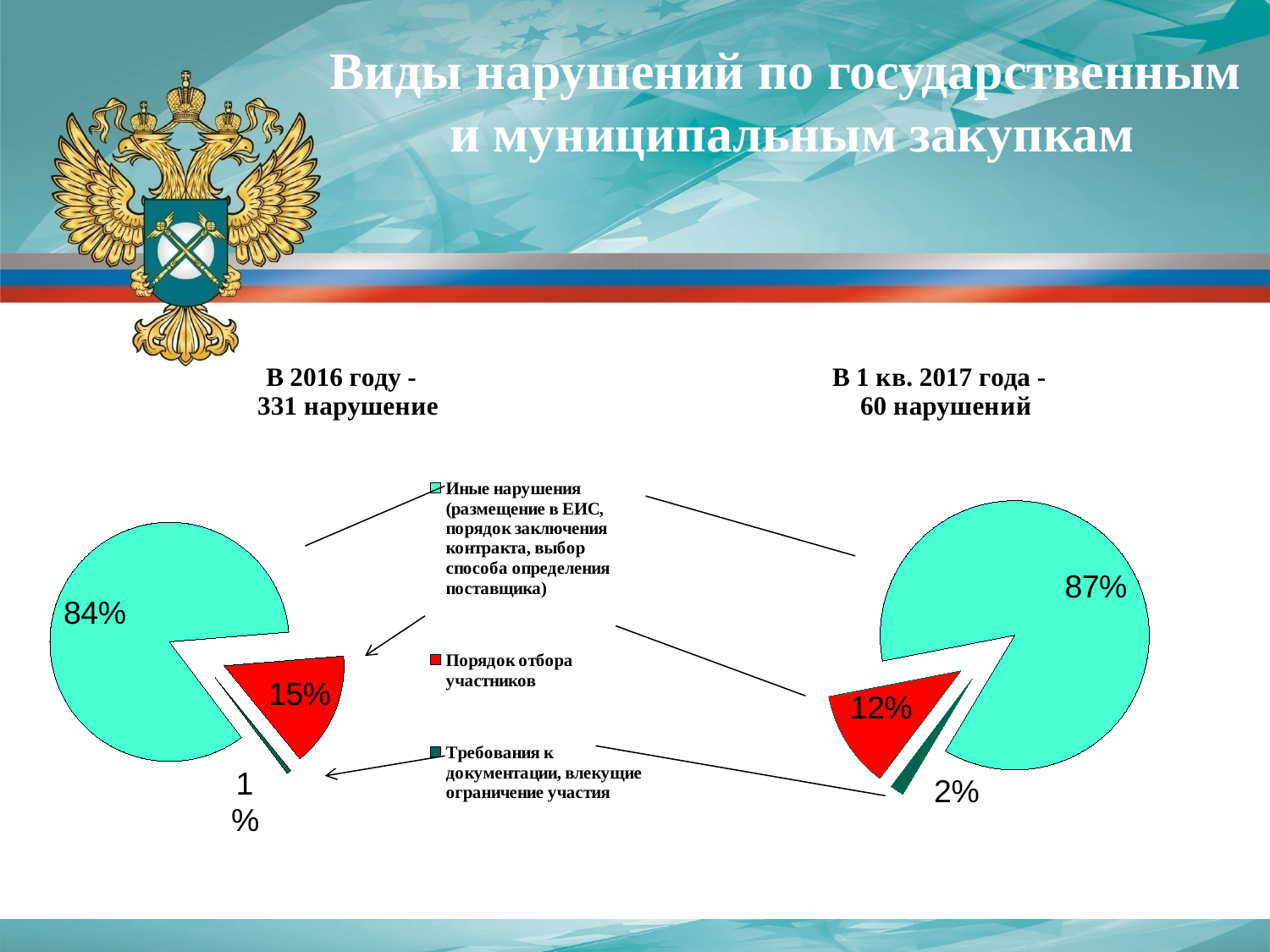
In the 2016 pie chart (left), what share is shown for 'Порядок отбора участников'? 15% In the 1st quarter 2017 pie chart (right), what share is shown for 'Требования к документации, влекущие ограничение участия'? 2% How many categories does the legend list? 3 What type of chart is used on this slide? Pie chart Which chart shows a larger share for 'Иные нарушения': the 2016 chart or the 1st quarter 2017 chart? 1st quarter 2017 chart In the 2016 pie chart (left), what share is labelled for the largest slice, 'Иные нарушения'? 84% In the 1st quarter 2017 pie chart (right), which category has the largest slice? Иные нарушения In the 1st quarter 2017 pie chart (right), what share is shown for 'Иные нарушения'? 87% What is the difference between the 'Порядок отбора участников' share in the 2016 chart and in the 1st quarter 2017 chart? 3% In the 2016 pie chart (left), what share is shown for 'Требования к документации, влекущие ограничение участия'? 1% In the 1st quarter 2017 pie chart (right), what share is shown for 'Порядок отбора участников'? 12% In the 2016 pie chart (left), which category has the smallest slice? Требования к документации, влекущие ограничение участия